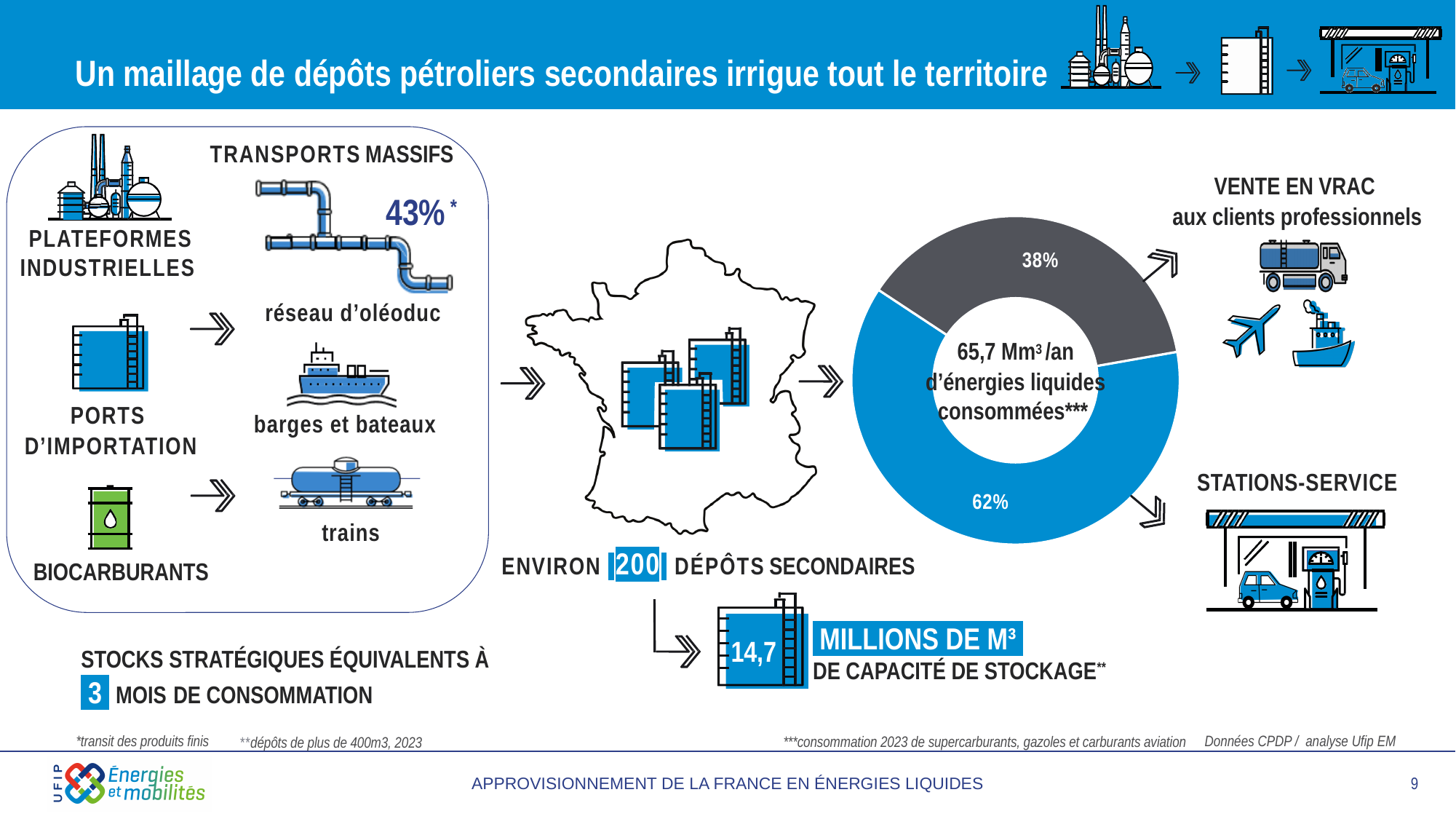
How many slices does the donut chart have? 2 Which slice of the donut chart is the largest? 62% (blue, stations-service) What percentage is shown on the blue slice of the donut chart? 62% What is the difference in percentage points between the two slices of the donut chart? 24 Which slice of the donut chart is the smallest? 38% (grey, vente en vrac) What kind of chart is shown in the middle-right of the slide? Pie chart (donut) What share of the donut chart goes to vente en vrac aux clients professionnels? 38% What colour is the slice representing stations-service in the donut chart? Blue What percentage is shown on the grey slice of the donut chart? 38% What share of the donut chart goes to stations-service? 62% What total volume is written in the centre of the donut chart? 65,7 Mm³/an Which is larger in the donut chart: the share for stations-service or the share for vente en vrac aux clients professionnels? Stations-service